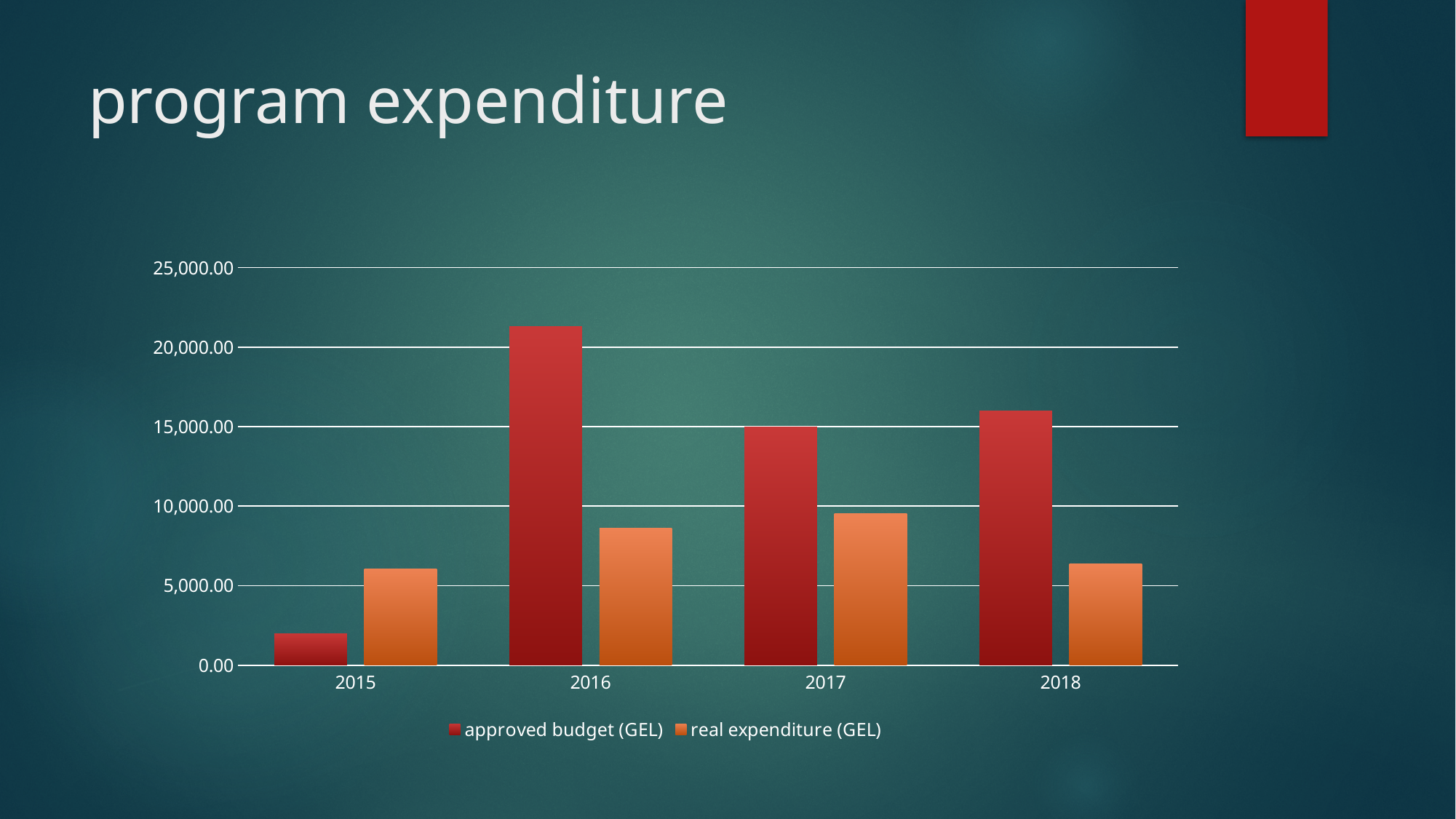
Which year has the highest approved budget (GEL)? 2016 Is the approved budget (GEL) for 2015 greater or less than 5,000.00? less Which year has the highest real expenditure (GEL)? 2017 In 2015, which is larger: the approved budget (GEL) or the real expenditure (GEL)? real expenditure (GEL) What is the title of the slide containing the chart? program expenditure Is the real expenditure (GEL) for 2017 greater or less than 10,000.00? less How many series does the legend list? 2 Is the approved budget (GEL) for 2016 greater or less than 20,000.00? greater Which year has the lowest approved budget (GEL)? 2015 How many years are shown on the x axis? 4 What kind of chart is shown on the slide? bar chart In 2018, which is larger: the approved budget (GEL) or the real expenditure (GEL)? approved budget (GEL)